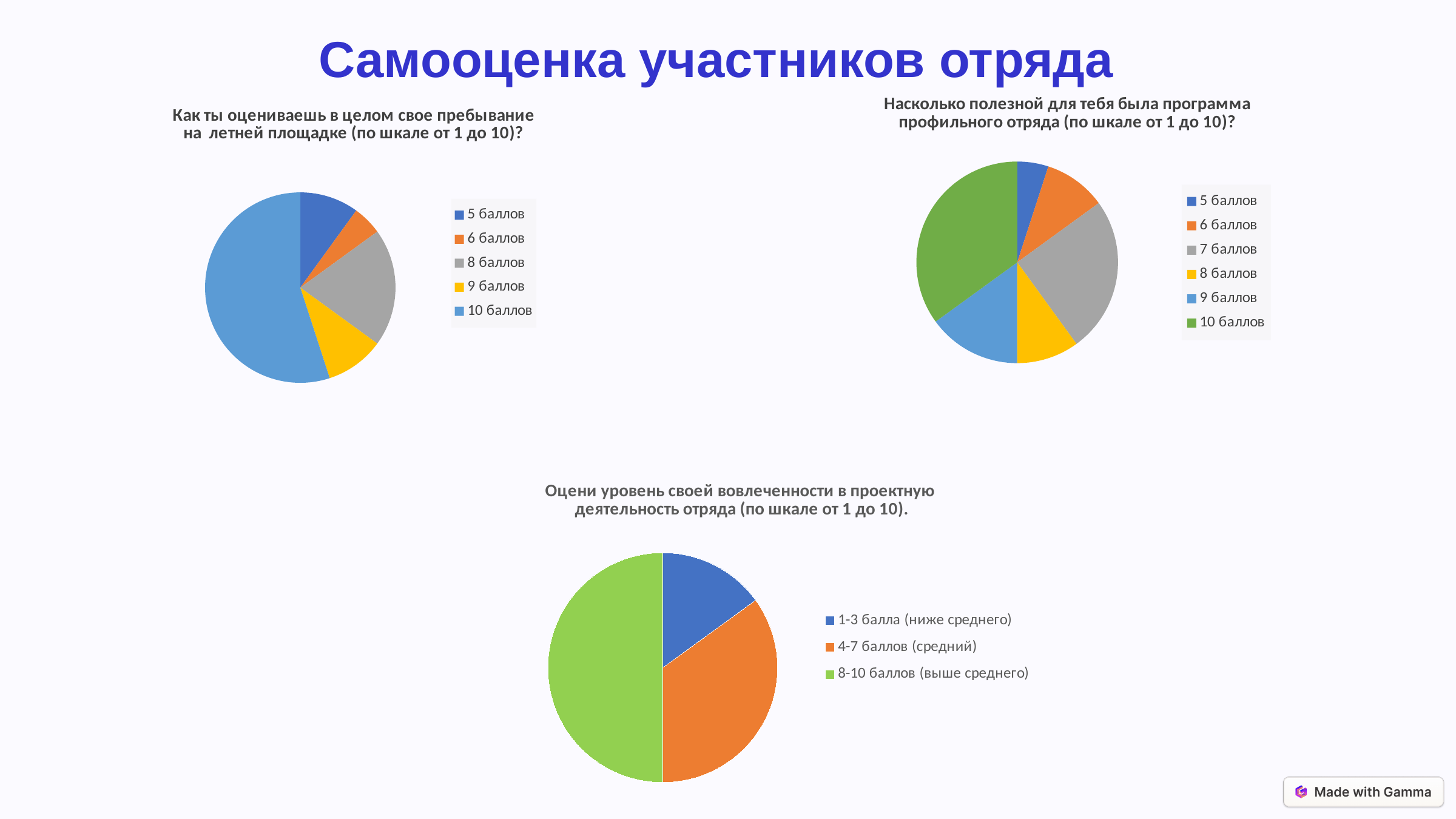
In the top-left pie chart ('Как ты оцениваешь в целом свое пребывание на летней площадке'), which category has the largest slice? 10 баллов In the top-left pie chart ('Как ты оцениваешь в целом свое пребывание на летней площадке'), which slice is larger: 8 баллов or 9 баллов? 8 баллов What kind of chart is used for the question 'Как ты оцениваешь в целом свое пребывание на летней площадке'? Pie chart In the top-right pie chart ('Насколько полезной для тебя была программа профильного отряда'), which category has the smallest slice? 5 баллов In the bottom pie chart ('Оцени уровень своей вовлеченности в проектную деятельность отряда'), which category has the largest slice? 8-10 баллов (выше среднего) In the top-left pie chart ('Как ты оцениваешь в целом свое пребывание на летней площадке'), which category has the smallest slice? 6 баллов In the top-right pie chart ('Насколько полезной для тебя была программа профильного отряда'), how many categories does the legend list? 6 In the bottom pie chart ('Оцени уровень своей вовлеченности в проектную деятельность отряда'), what colour is the slice for '4-7 баллов (средний)'? Orange In the top-right pie chart ('Насколько полезной для тебя была программа профильного отряда'), which slice is larger: 7 баллов or 9 баллов? 7 баллов In the bottom pie chart ('Оцени уровень своей вовлеченности в проектную деятельность отряда'), how many categories does the legend list? 3 In the top-left pie chart ('Как ты оцениваешь в целом свое пребывание на летней площадке'), how many categories does the legend list? 5 In the top-right pie chart ('Насколько полезной для тебя была программа профильного отряда'), which category has the largest slice? 10 баллов